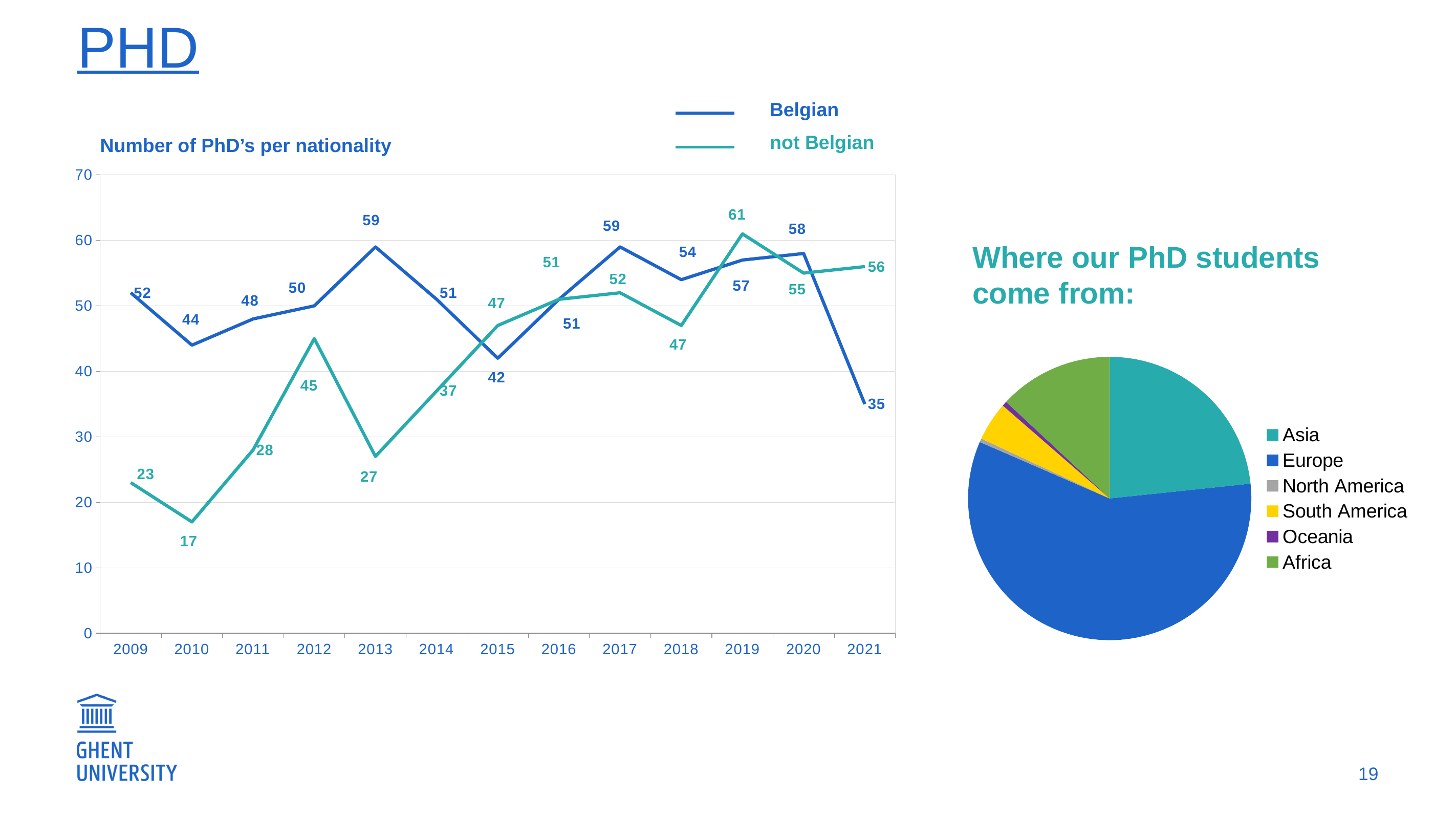
In the 'Number of PhD's per nationality' chart, what is the value for Belgian in 2021? 35 In the 'Number of PhD's per nationality' chart, which series has the larger value in 2020, Belgian or not Belgian? Belgian In the 'Number of PhD's per nationality' chart, what is the difference between the Belgian and not Belgian values in 2009? 29 In the 'Number of PhD's per nationality' chart, in which year is the not Belgian value highest? 2019 In the 'Number of PhD's per nationality' chart, in which year is the Belgian value lowest? 2021 In the 'Where our PhD students come from' pie chart, which region has the largest slice? Europe In the 'Number of PhD's per nationality' chart, what is the value for not Belgian in 2019? 61 How many series does the legend of the 'Number of PhD's per nationality' chart list? 2 What kind of chart is 'Number of PhD's per nationality'? Line chart In the 'Number of PhD's per nationality' chart, in which year is the not Belgian value lowest? 2010 In the 'Number of PhD's per nationality' chart, how many years are shown on the x axis? 13 In the 'Number of PhD's per nationality' chart, what is the value for Belgian in 2013? 59